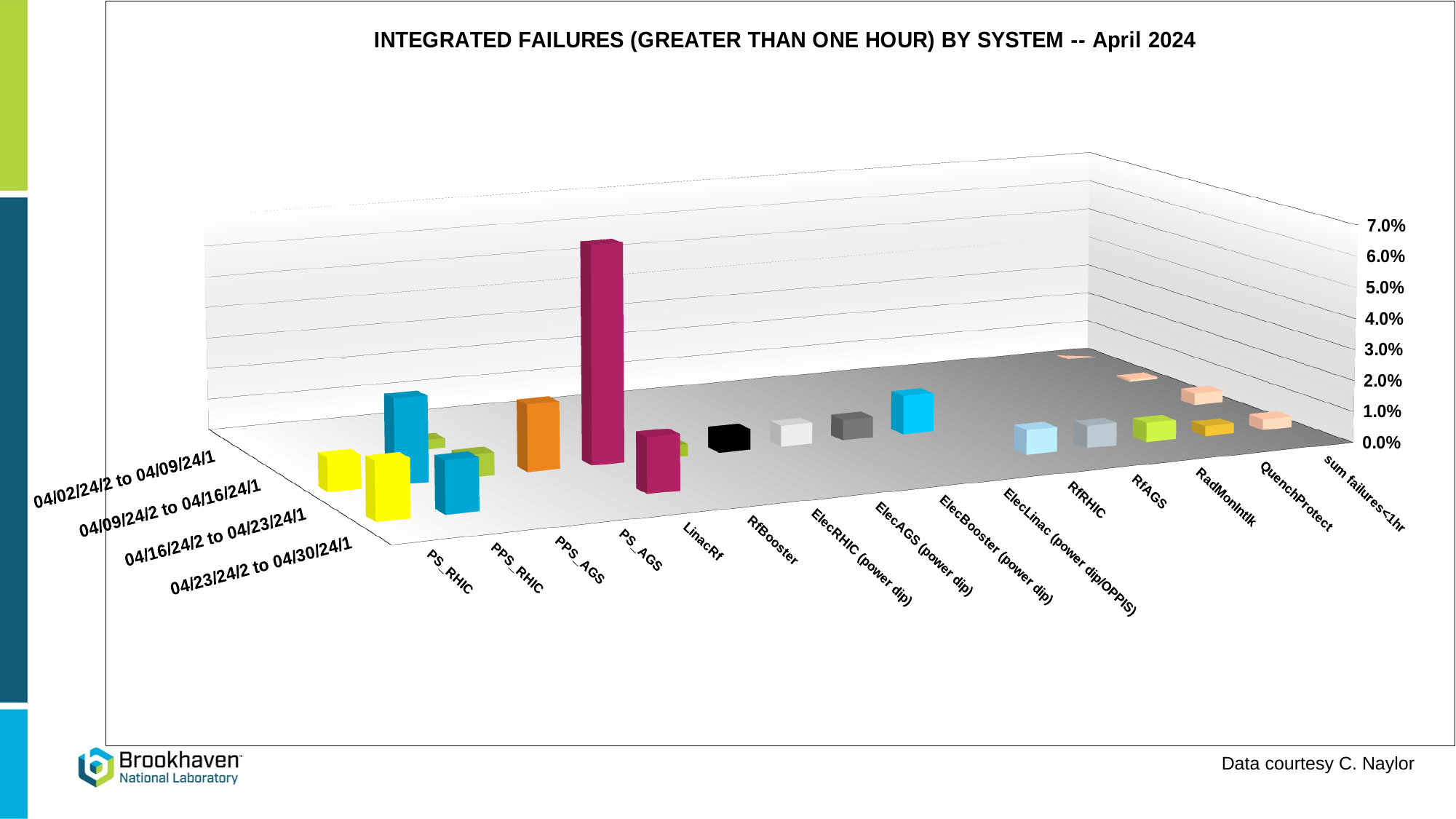
How many system categories are shown along the x axis of the chart? 15 What kind of chart is shown on the slide? bar chart What is the title of the chart? INTEGRATED FAILURES (GREATER THAN ONE HOUR) BY SYSTEM -- April 2024 Is the tallest bar for PS_AGS greater or less than 3.0%? less What is the first system category listed on the x axis? PS_RHIC Which date range is listed first on the depth axis of the chart? 04/02/24/2 to 04/09/24/1 What is the highest value shown on the vertical axis of the chart? 7.0% Is the tallest bar for PS_AGS greater or less than 7.0%? less Which system has the tallest bar in the chart? LinacRf What is the last category listed on the x axis? sum failures<1hr How many date-range rows are plotted in the chart? 4